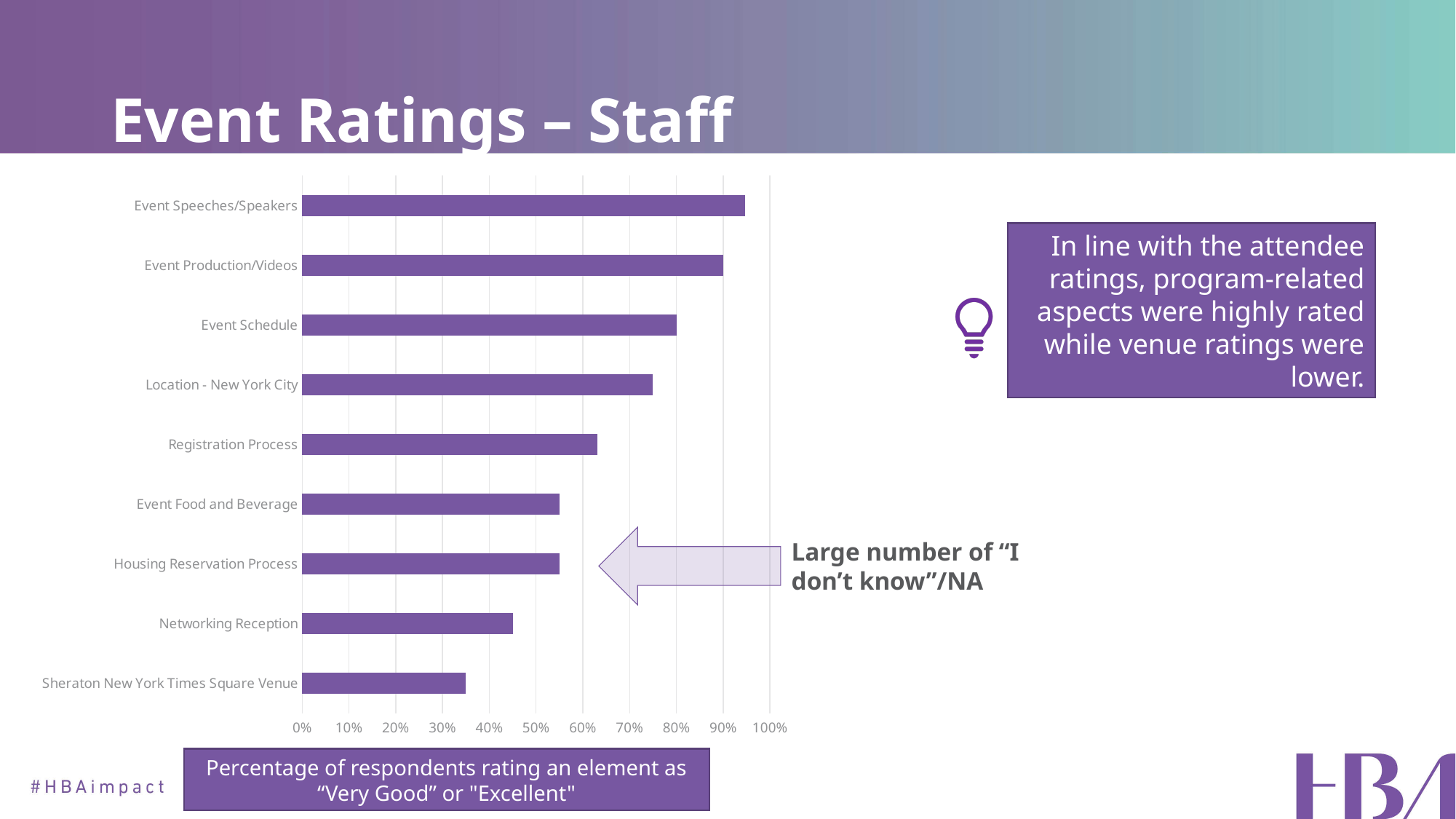
Which is rated higher, Registration Process or Event Food and Beverage? Registration Process Is the value for Registration Process greater or less than 60%? greater Is the value for Event Speeches/Speakers greater or less than 90%? greater Which category has the highest rating in the chart? Event Speeches/Speakers How many categories are plotted in the chart? 9 Is the value for Location - New York City greater or less than 70%? greater Which category has the lowest rating in the chart? Sheraton New York Times Square Venue Which is rated higher, Event Schedule or Networking Reception? Event Schedule What kind of chart is shown on the slide? bar chart What does the caption below the chart say the bars represent? Percentage of respondents rating an element as "Very Good" or "Excellent"